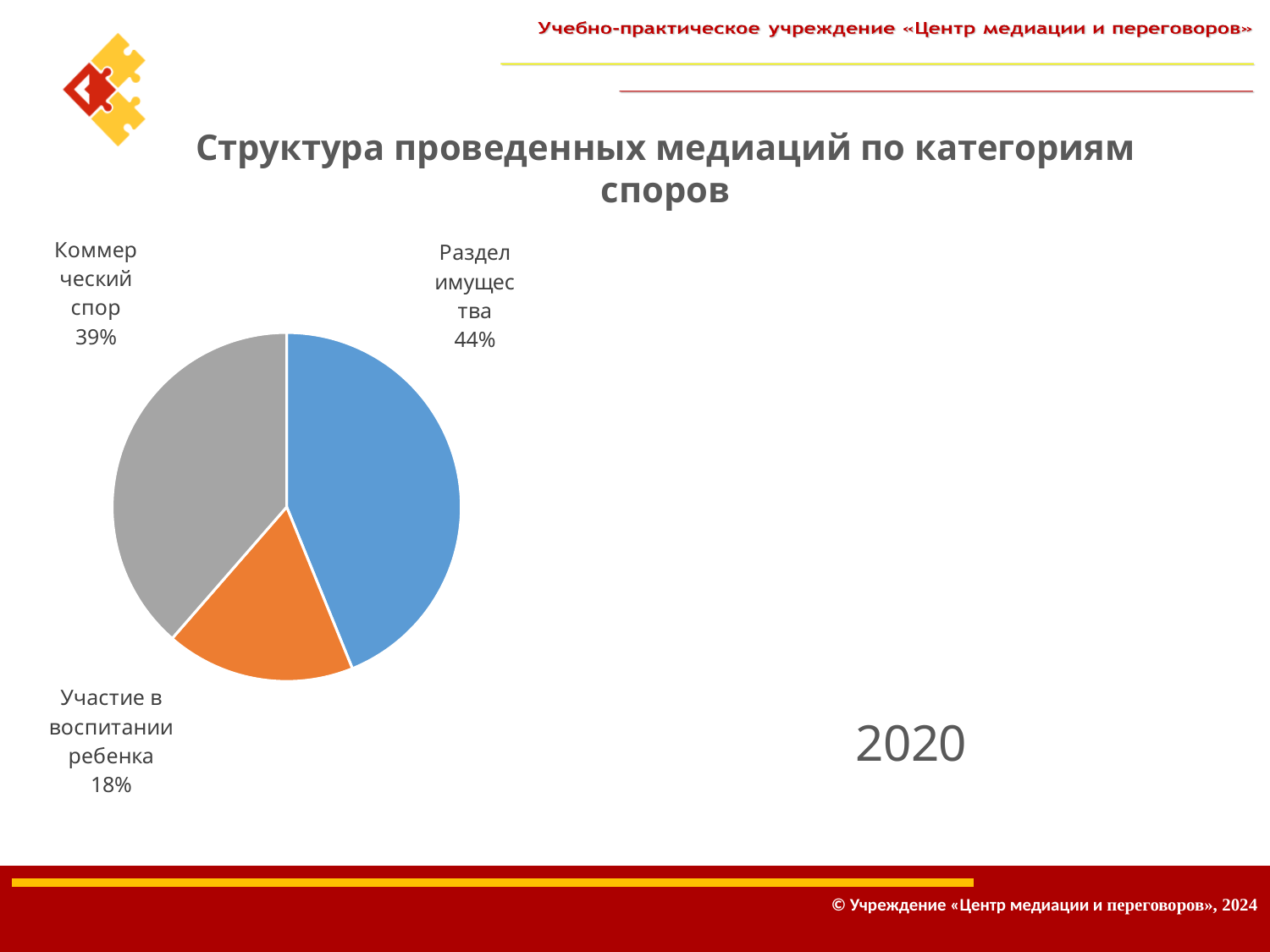
What share of the pie does "Раздел имущества" have? 44% What is the difference in percentage points between "Раздел имущества" and "Коммерческий спор"? 5 What kind of chart is shown on the slide? pie chart What is the difference in percentage points between "Раздел имущества" and "Участие в воспитании ребенка"? 26 What share of the pie does "Коммерческий спор" have? 39% Which category has the largest slice of the pie? Раздел имущества How many categories are shown in the pie chart? 3 Which is larger: the share for "Коммерческий спор" or the share for "Участие в воспитании ребенка"? Коммерческий спор What is the title of the chart? Структура проведенных медиаций по категориям споров Which category has the smallest slice of the pie? Участие в воспитании ребенка Which year is shown next to the chart? 2020 What share of the pie does "Участие в воспитании ребенка" have? 18%